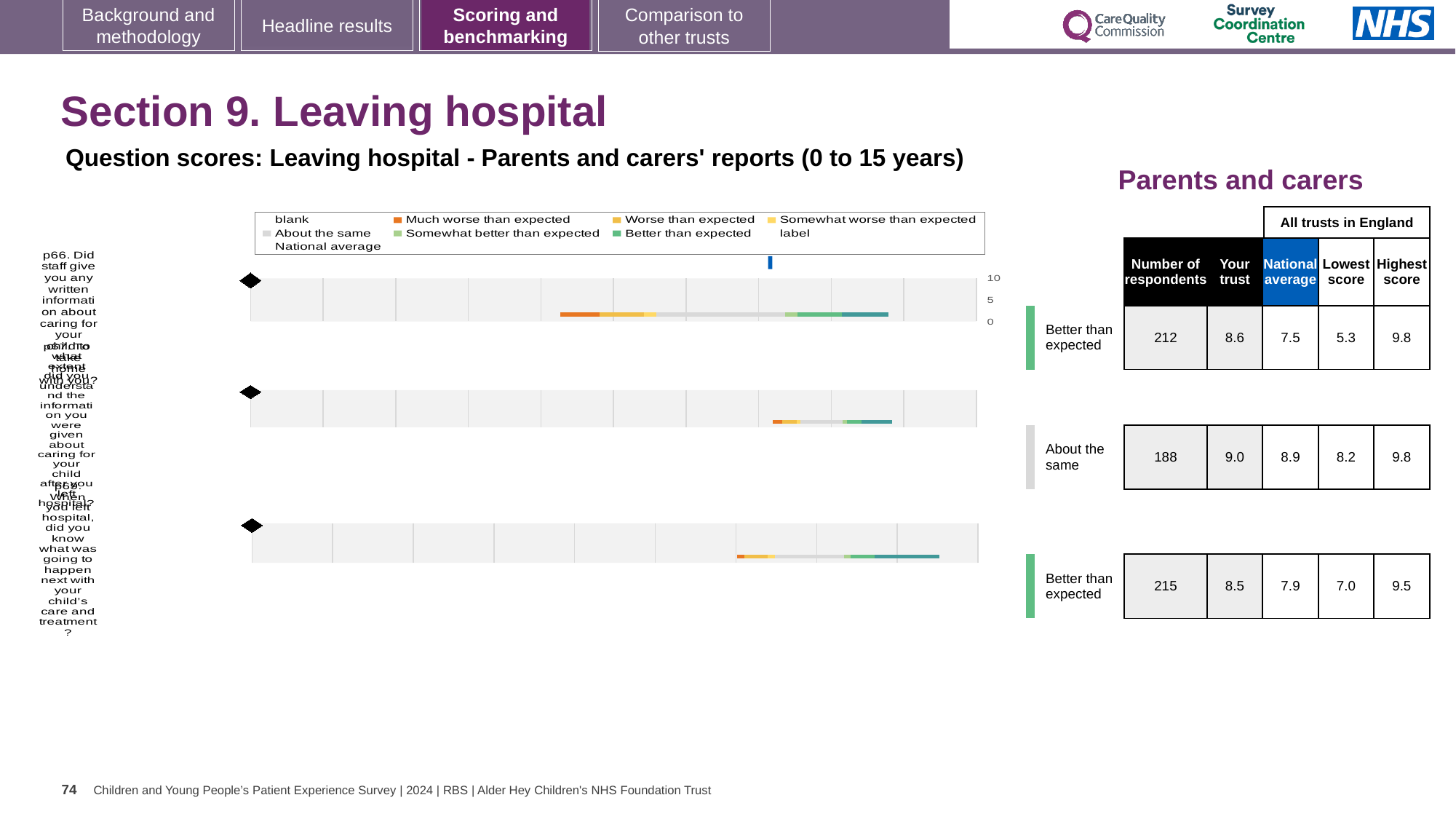
What kind of chart is used to show the question scores on this slide? bar chart For the bottom chart (p68), what is the lowest score across all trusts in England? 7.0 For the top chart (p66), what is the difference between the 'Your trust' score and the national average? 1.1 How many question charts are shown on the slide? 3 In the chart legend, which colour represents 'Much worse than expected'? orange For the top chart (p66, written information about caring for your child), what is the 'Your trust' score in the table? 8.6 For the top chart (p66), what is the national average score? 7.5 Which of the three charts has the highest 'Your trust' score? the middle chart (p67), 9.0 What benchmark category is shown for the middle chart (p67)? About the same For the top chart (p66), which is larger: the 'Your trust' score or the national average? Your trust For the middle chart (p67), how many respondents are listed? 188 For the bottom chart (p68), what is the highest score across all trusts in England? 9.5